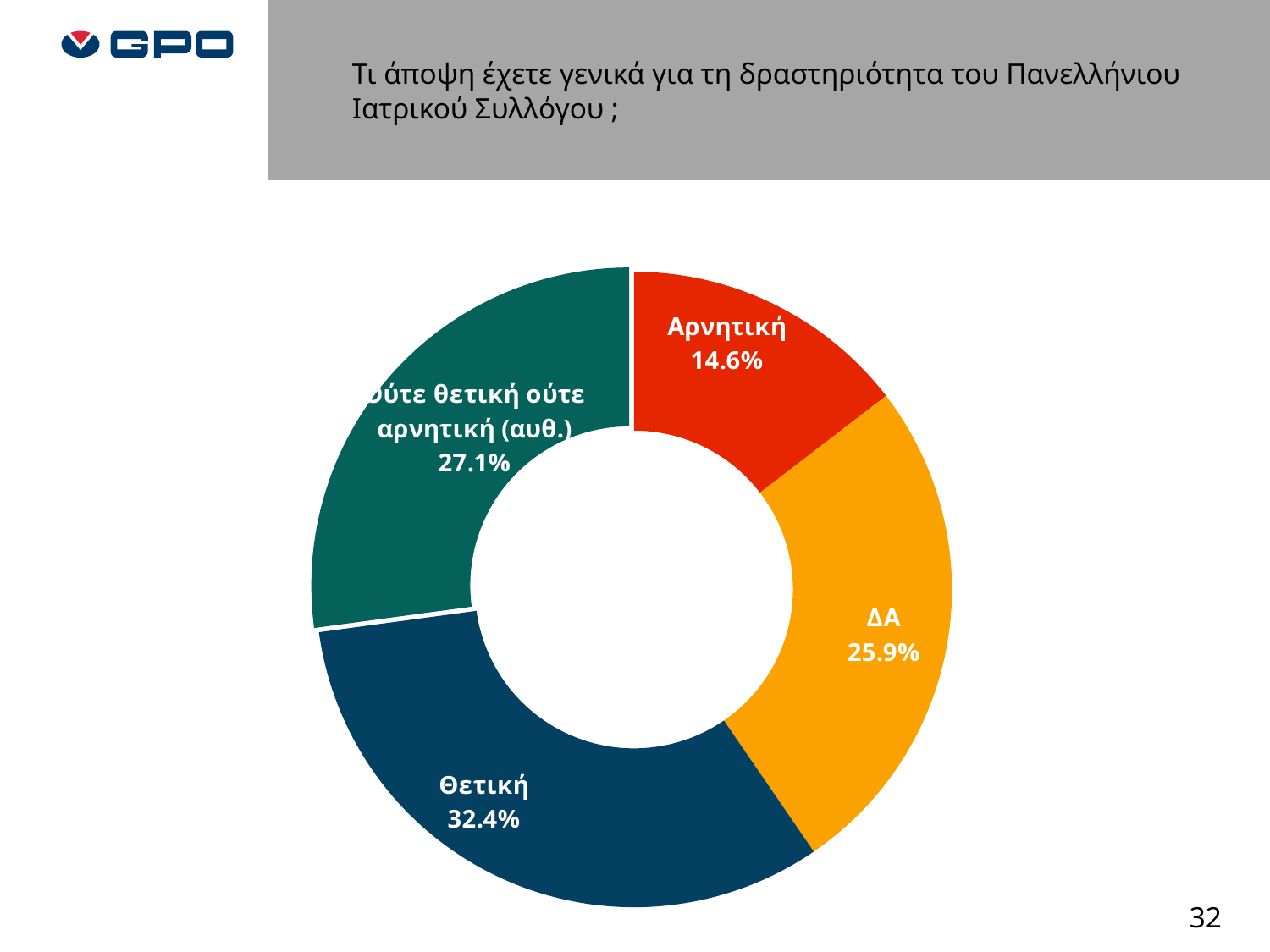
What is the value shown for ΔΑ? 25.9% What is the difference in percentage points between Θετική and Αρνητική? 17.8 What percentage of respondents answered Αρνητική? 14.6% What is the value shown for Ούτε θετική ούτε αρνητική (αυθ.)? 27.1% Which category has the smallest share of the chart? Αρνητική What colour is the Θετική slice? Dark blue Which is larger, the share for ΔΑ or the share for Αρνητική? ΔΑ What kind of chart is shown on the slide? Pie (doughnut) chart What percentage of respondents answered Θετική? 32.4% How many categories are shown in the chart? 4 What is the difference in percentage points between Ούτε θετική ούτε αρνητική (αυθ.) and ΔΑ? 1.2 Which category has the largest share of the chart? Θετική